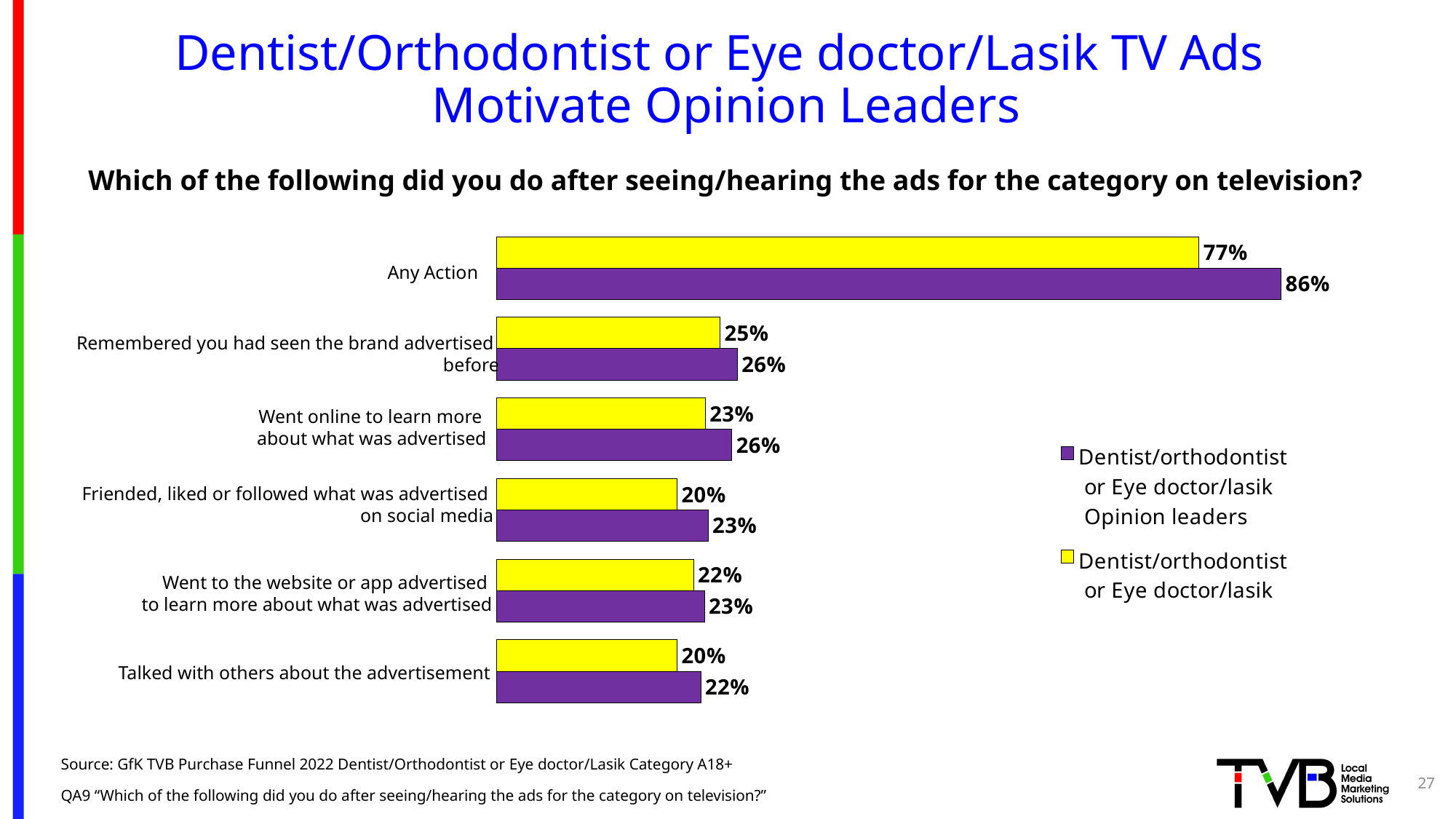
What is the value for 'Went to the website or app advertised to learn more about what was advertised' for the Dentist/orthodontist or Eye doctor/lasik series? 22% Which category has the highest value for Opinion leaders? Any Action What is the value for 'Went online to learn more about what was advertised' for the Dentist/orthodontist or Eye doctor/lasik series (yellow bars)? 23% How many series does the legend list? 2 How many categories are shown on the chart? 6 What is the difference between the Opinion leaders and the Dentist/orthodontist or Eye doctor/lasik values for 'Went online to learn more about what was advertised'? 3% What colour are the bars for the Opinion leaders series? Purple What is the value for 'Talked with others about the advertisement' for Opinion leaders? 22% What kind of chart is shown on the slide? Bar chart What is the difference between the Opinion leaders and the Dentist/orthodontist or Eye doctor/lasik values for Any Action? 9% What percentage of Dentist/orthodontist or Eye doctor/lasik Opinion leaders took Any Action after seeing the ads? 86% For 'Friended, liked or followed what was advertised on social media', which series has the larger value: Opinion leaders or Dentist/orthodontist or Eye doctor/lasik? Opinion leaders